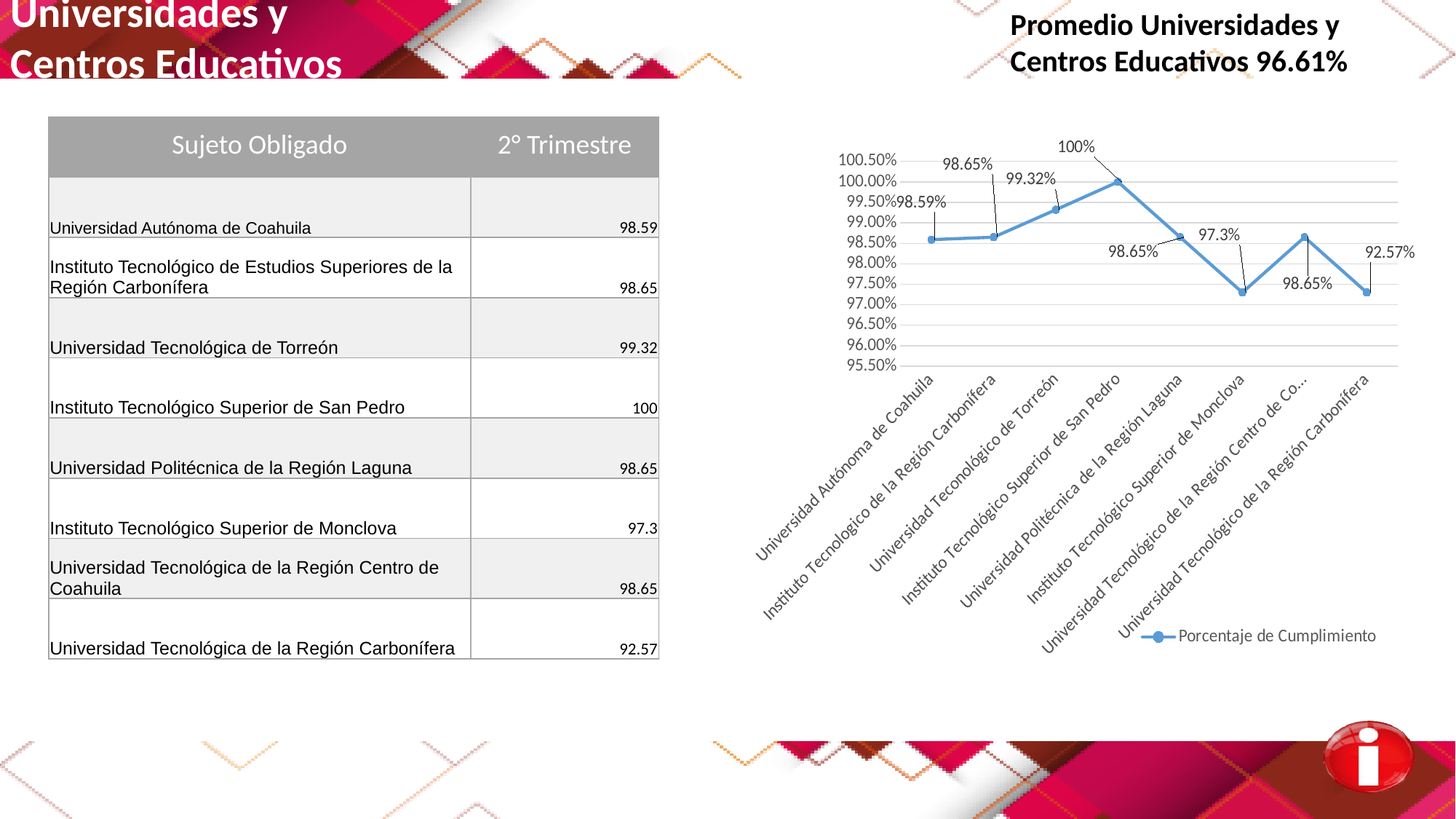
What kind of chart is shown on the slide? line chart Which category has the highest value in the chart? Instituto Tecnológico Superior de San Pedro What is the value for Instituto Tecnológico Superior de Monclova in the chart? 97.3% What is the value for Universidad Tecnológica de Torreón in the chart? 99.32% How many series does the chart legend list? 1 What is the name of the series shown in the chart legend? Porcentaje de Cumplimiento How many categories are plotted on the x axis of the chart? 8 What is the value for Universidad Autónoma de Coahuila in the chart? 98.59% Which is larger, the value for Universidad Tecnológica de Torreón or the value for Instituto Tecnológico Superior de Monclova? Universidad Tecnológica de Torreón What is the value for Instituto Tecnológico Superior de San Pedro in the chart? 100%